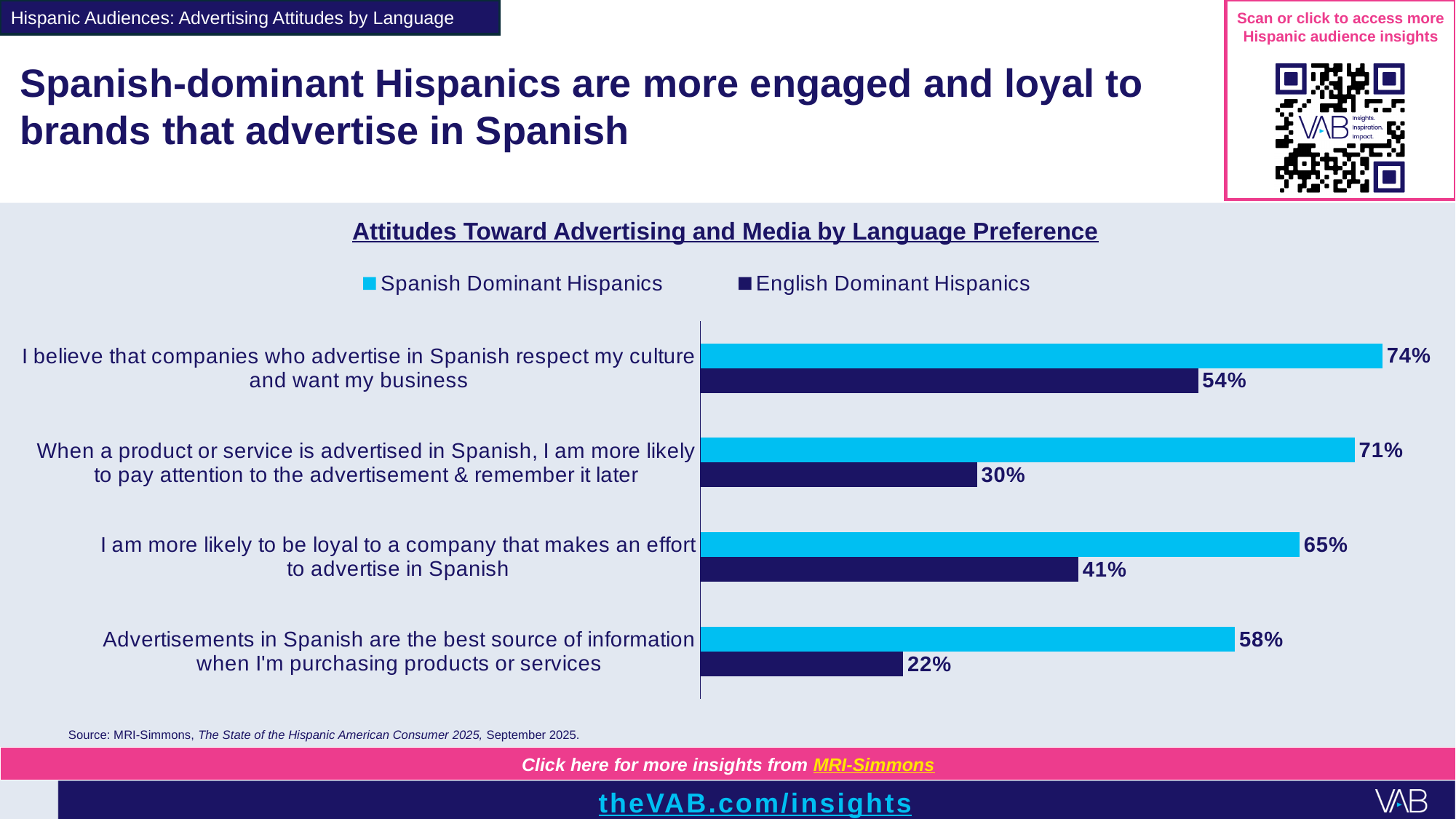
What is the title of the chart? Attitudes Toward Advertising and Media by Language Preference What is the difference between Spanish Dominant and English Dominant Hispanics on the statement 'I am more likely to be loyal to a company that makes an effort to advertise in Spanish'? 24 percentage points What percentage of Spanish Dominant Hispanics believe that companies who advertise in Spanish respect their culture and want their business? 74% Which statement has the highest value for Spanish Dominant Hispanics? I believe that companies who advertise in Spanish respect my culture and want my business What type of chart is shown on the slide? Bar chart Which statement has the lowest value for English Dominant Hispanics? Advertisements in Spanish are the best source of information when I'm purchasing products or services What is the difference between Spanish Dominant and English Dominant Hispanics on the statement 'When a product or service is advertised in Spanish, I am more likely to pay attention to the advertisement & remember it later'? 41 percentage points What is the value for English Dominant Hispanics on the statement 'Advertisements in Spanish are the best source of information when I'm purchasing products or services'? 22% How many statements (categories) are shown in the chart? 4 What percentage of English Dominant Hispanics say that when a product or service is advertised in Spanish, they are more likely to pay attention to the advertisement and remember it later? 30% How many series does the legend list? 2 Which group has the larger value for 'I believe that companies who advertise in Spanish respect my culture and want my business'? Spanish Dominant Hispanics